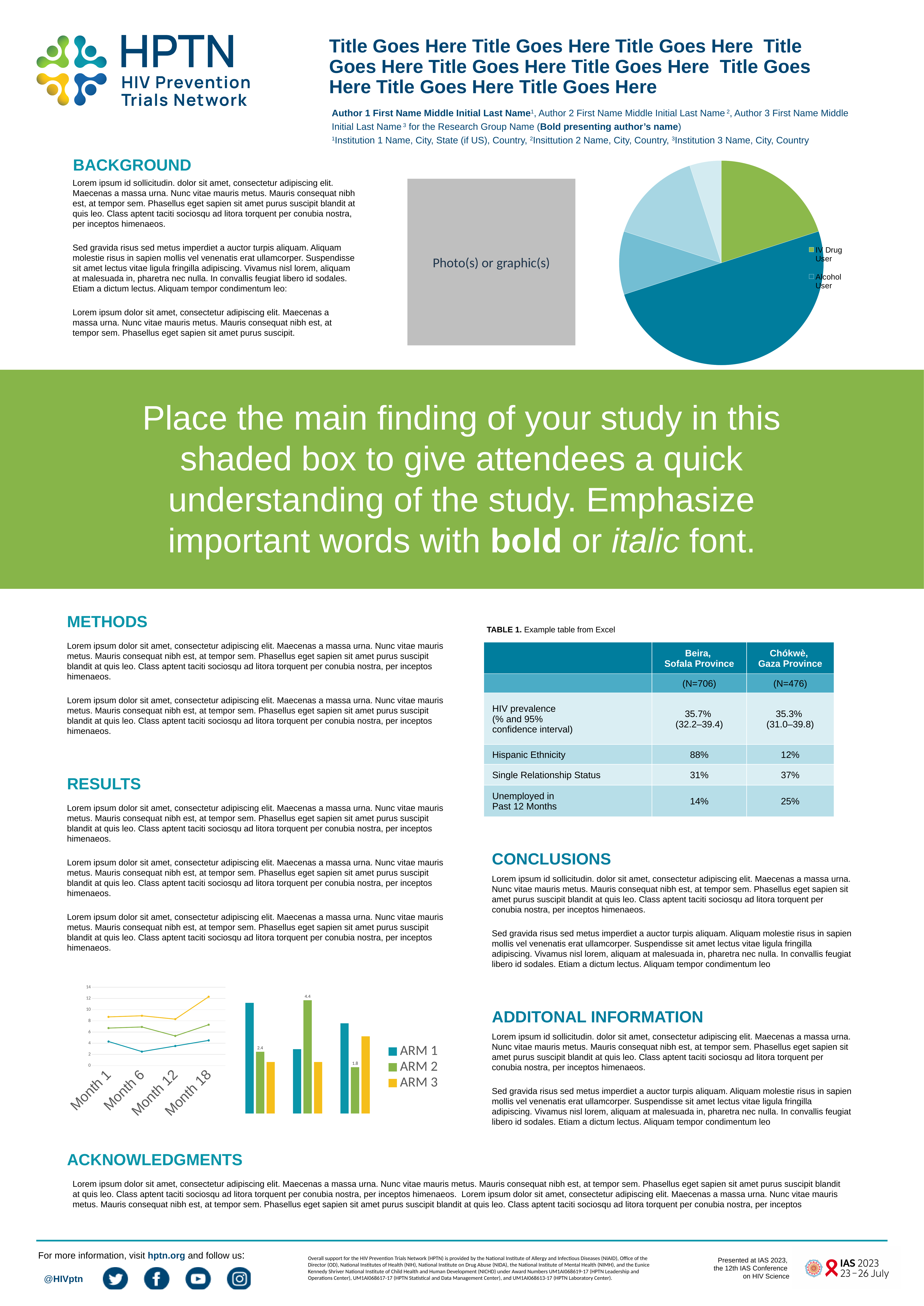
In the line chart at the bottom left, is the value of the teal line at Month 6 greater or less than 4? less In the pie chart at the top right, which legend entry is shown with the green colour? IV Drug User What kind of chart is shown at the top right of the poster? pie chart In the bar chart with ARM 1, ARM 2 and ARM 3, what is the labelled value of the ARM 2 bar in the second group of bars? 4.4 In the pie chart at the top right, how many slices does the pie have? 5 What kind of chart is the chart at the bottom left with Month 1 to Month 18 on the x axis? line chart In the line chart at the bottom left, does the teal line rise or fall from Month 1 to Month 6? fall In the line chart at the bottom left, how many months are shown on the x axis? 4 How many series does the legend of the bar chart with ARM 1, ARM 2 and ARM 3 list? 3 In the line chart at the bottom left, is the value of the yellow line at Month 18 greater or less than 10? greater In the bar chart with ARM 1, ARM 2 and ARM 3, what is the difference between the ARM 2 values labelled in the second group (4.4) and the third group (1.8)? 2.6 In the pie chart at the top right, which of the two labelled slices is larger, IV Drug User or Alcohol User? Alcohol User